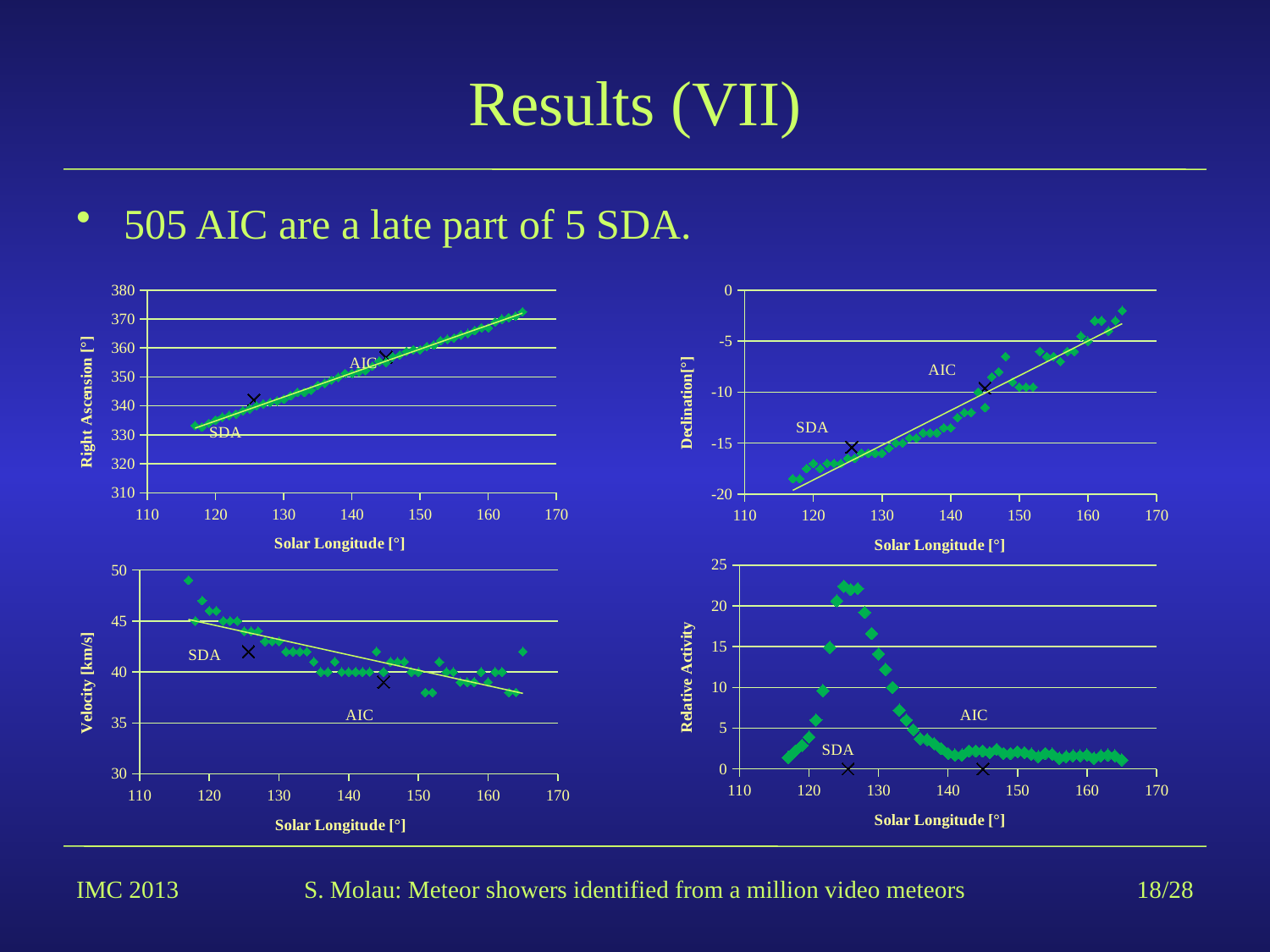
In the Declination chart (top right), is the value at the lowest plotted Solar Longitude (around 117°) greater or less than -15? less In the Relative Activity chart (bottom right), is the peak value greater or less than 20? greater In the Relative Activity chart (bottom right), is the value at Solar Longitude 160° greater or less than 5? less What is the y-axis label of the chart at the bottom left of the slide? Velocity [km/s] In the Velocity chart (bottom left), do the values rise or fall as Solar Longitude increases? fall In the Right Ascension chart (top left), do the values rise or fall as Solar Longitude increases? rise In the Declination chart (top right), do the values rise or fall as Solar Longitude increases? rise In the Velocity chart (bottom left), which has the larger velocity: the points near Solar Longitude 120° or those near 160°? near 120° How many charts are shown on the slide? 4 What kind of chart is the Right Ascension chart at the top left of the slide? scatter chart